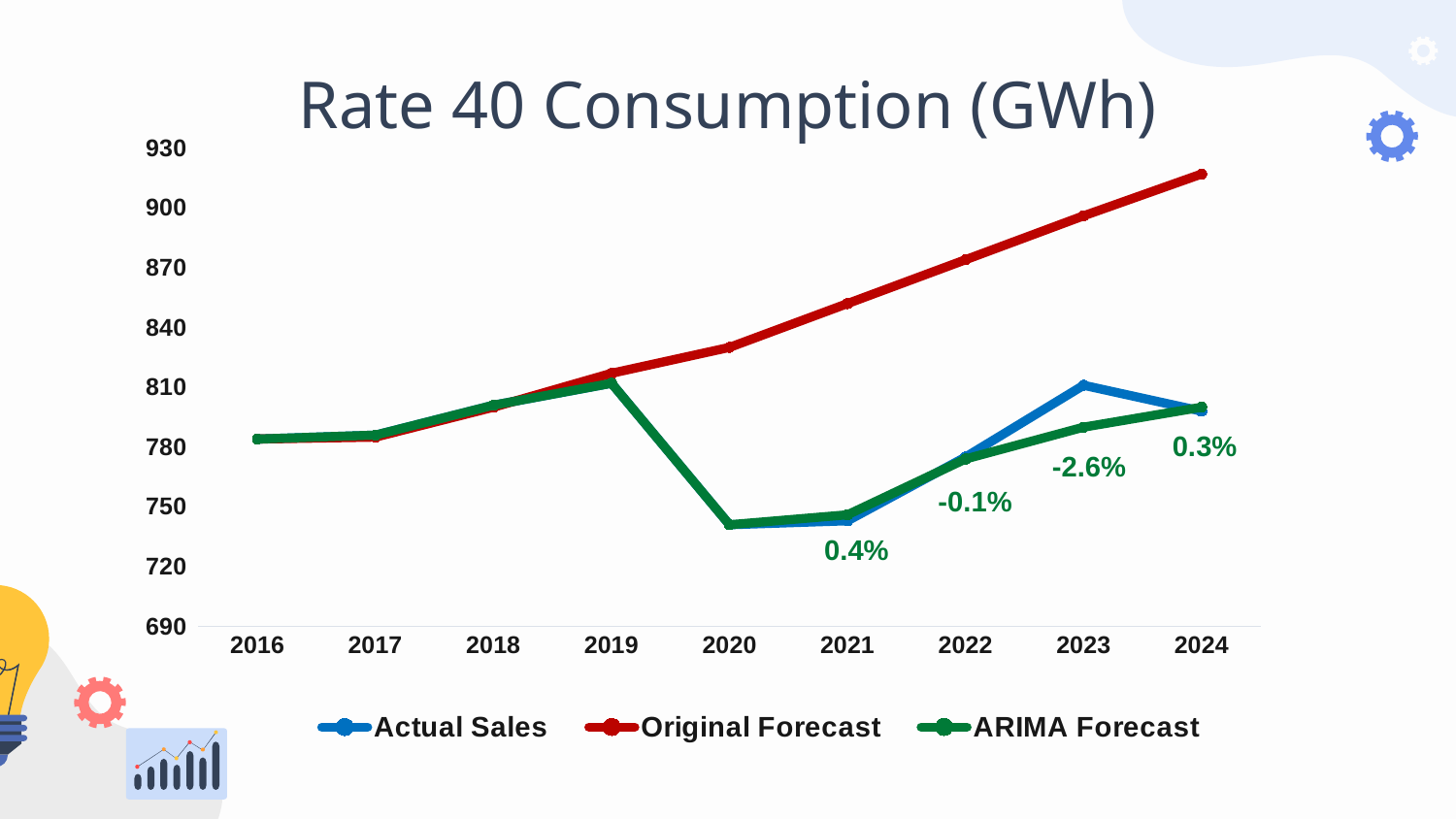
What percentage label is shown for 2023? -2.6% What is the title of the chart? Rate 40 Consumption (GWh) In 2024, which is higher: the Original Forecast or the ARIMA Forecast? Original Forecast What kind of chart is shown on the slide? line chart Which colour is used for the Original Forecast series? red Does the Original Forecast rise or fall from 2016 to 2024? rise Is the Original Forecast value for 2024 greater or less than 900? greater Is the ARIMA Forecast value for 2020 greater or less than 750? less How many series does the legend list? 3 In which year is the ARIMA Forecast at its lowest? 2020 What percentage label is shown for 2021? 0.4% How many years are shown on the x axis? 9